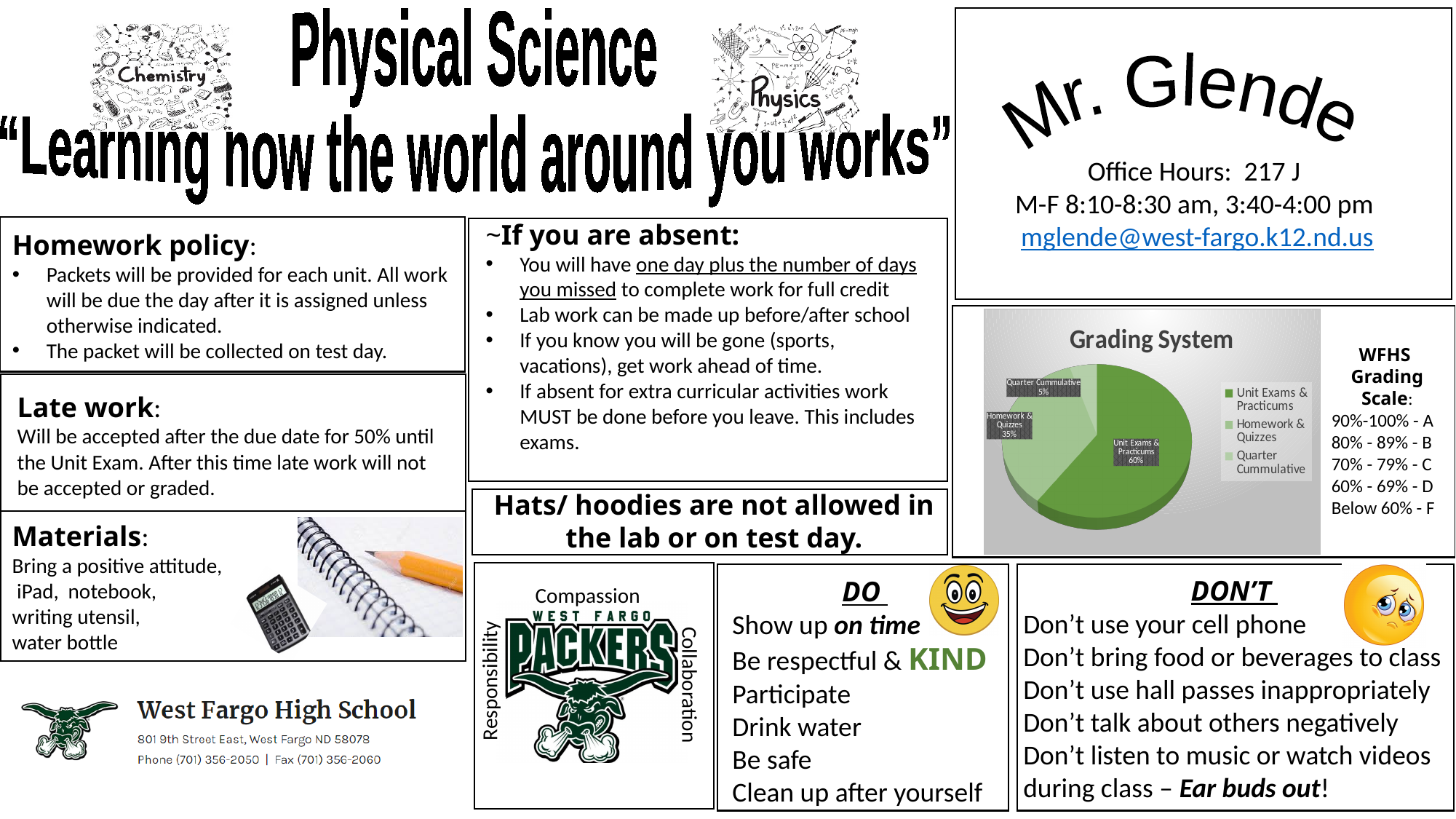
What share of the "Grading System" pie is Quarter Cummulative? 5% How many entries does the legend of the "Grading System" chart list? 3 In the "Grading System" chart, which is larger: Homework & Quizzes or Quarter Cummulative? Homework & Quizzes Which category has the smallest slice in the "Grading System" pie chart? Quarter Cummulative Which category has the largest slice in the "Grading System" pie chart? Unit Exams & Practicums How many slices does the "Grading System" pie chart have? 3 In the "Grading System" chart, what is the difference between the Unit Exams & Practicums share and the Homework & Quizzes share? 25% What is the title of the chart on the slide? Grading System What share of the "Grading System" pie is Unit Exams & Practicums? 60% What kind of chart is the "Grading System" chart? pie chart In the "Grading System" chart, what is the combined share of Homework & Quizzes and Quarter Cummulative? 40% What share of the "Grading System" pie is Homework & Quizzes? 35%